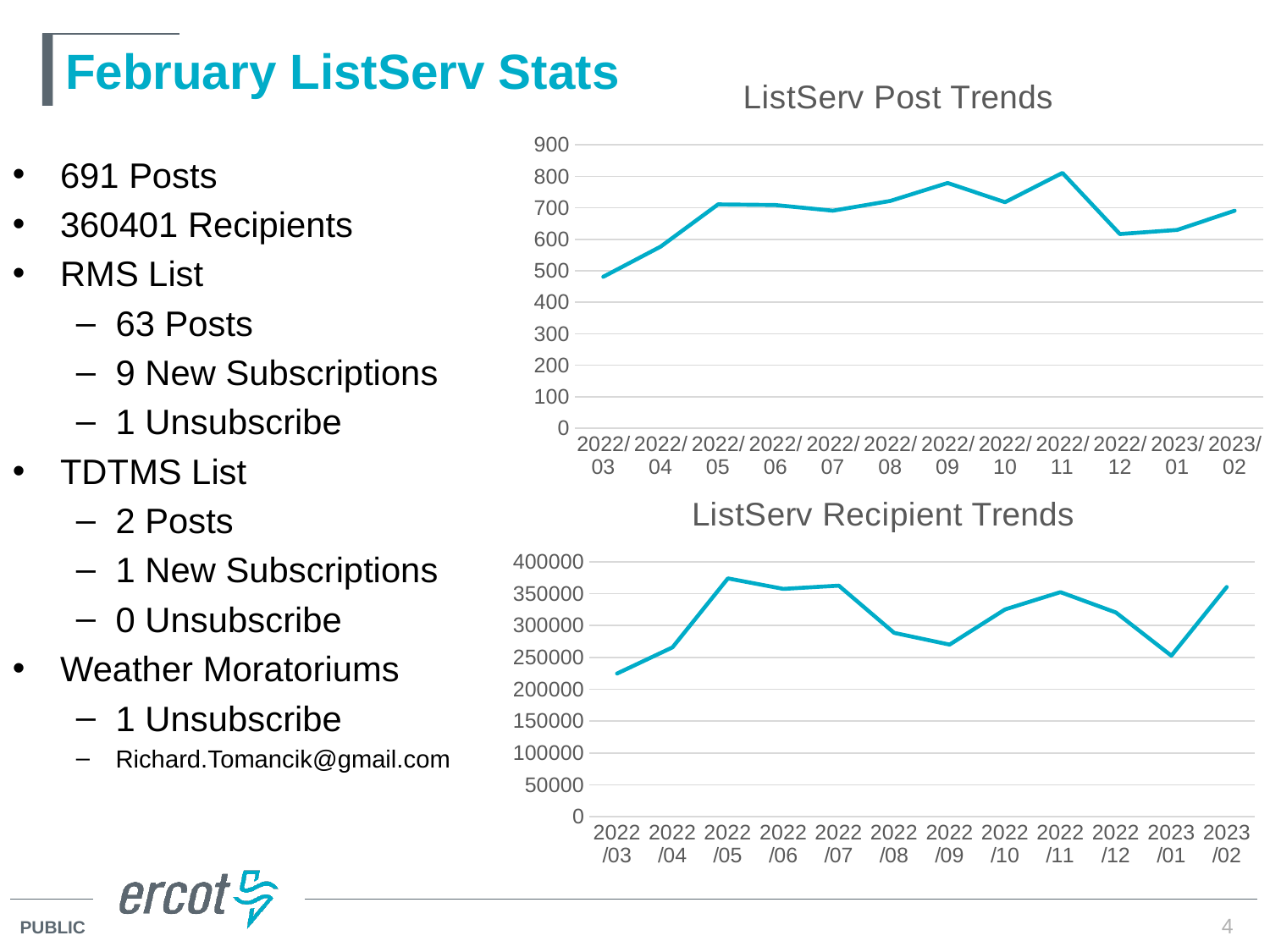
On the "ListServ Recipient Trends" chart, do the values rise or fall from 2023/01 to 2023/02? rise On the "ListServ Post Trends" chart, which month has the lowest value? 2022/03 How many data points are plotted on the "ListServ Post Trends" chart? 12 On the "ListServ Recipient Trends" chart, which month has the lowest value? 2022/03 What kind of chart is the "ListServ Post Trends" chart? line chart On the "ListServ Post Trends" chart, is the value for 2022/03 greater or less than 500? less On the "ListServ Post Trends" chart, which month has the highest value? 2022/11 On the "ListServ Recipient Trends" chart, is the value for 2022/09 greater or less than 300000? less On the "ListServ Recipient Trends" chart, which month has the highest value? 2022/05 How many data points are plotted on the "ListServ Recipient Trends" chart? 12 On the "ListServ Post Trends" chart, which is larger, the value for 2022/11 or the value for 2022/12? 2022/11